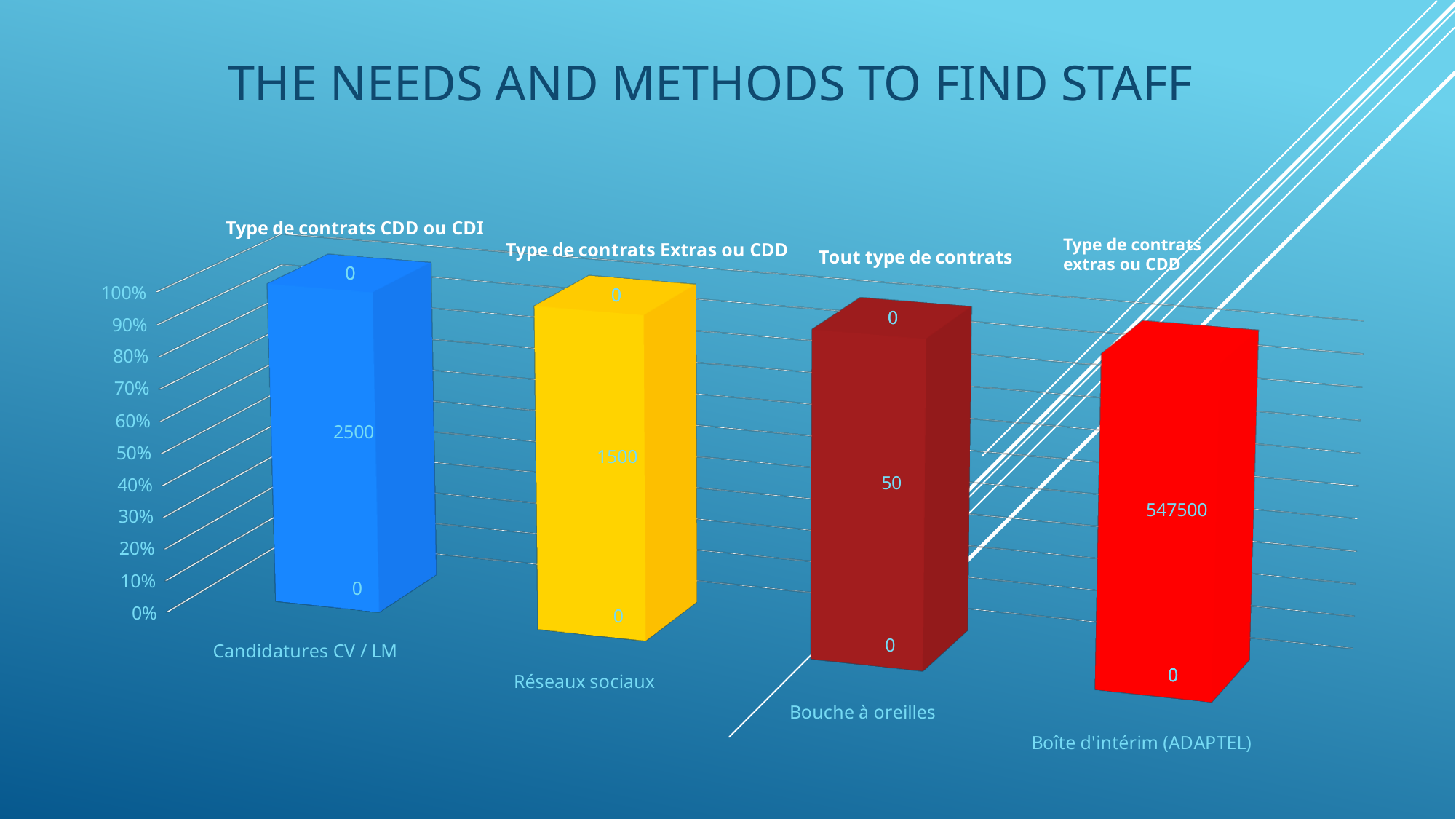
Which category has the lowest non-zero labelled value? Bouche à oreilles How many categories are shown on the x axis? 4 Which has a larger labelled value, Réseaux sociaux or Bouche à oreilles? Réseaux sociaux What is the data label shown in the middle of the bar for Bouche à oreilles? 50 What is the data label shown in the middle of the bar for Boîte d'intérim (ADAPTEL)? 547500 What is the title of the slide? THE NEEDS AND METHODS TO FIND STAFF What is the data label shown in the middle of the bar for Candidatures CV / LM? 2500 What colour is the bar for Réseaux sociaux? Yellow What is the difference between the labelled values for Candidatures CV / LM and Réseaux sociaux? 1000 Which category has the highest labelled value? Boîte d'intérim (ADAPTEL) What kind of chart is shown on the slide? Bar chart What is the data label shown in the middle of the bar for Réseaux sociaux? 1500